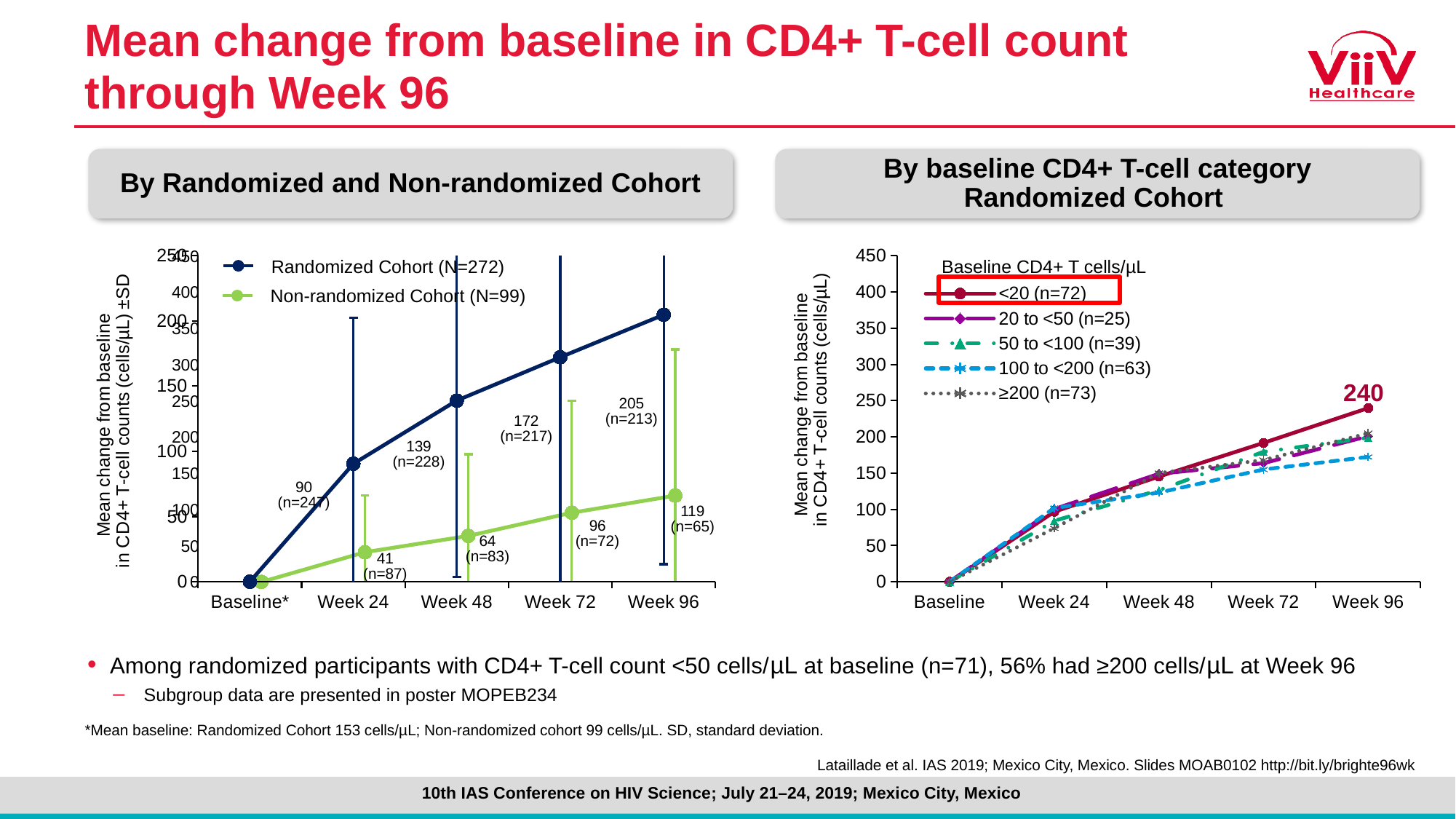
In the 'By baseline CD4+ T-cell category Randomized Cohort' chart, which baseline CD4+ category has the highest value at Week 96? <20 (n=72) In the 'By baseline CD4+ T-cell category Randomized Cohort' chart, how many series does the legend list? 5 In the 'By Randomized and Non-randomized Cohort' chart, which cohort has the larger mean change at Week 72? Randomized Cohort In the 'By baseline CD4+ T-cell category Randomized Cohort' chart, what is the value for the <20 (n=72) group at Week 96? 240 In the 'By Randomized and Non-randomized Cohort' chart, how many series does the legend list? 2 In the 'By Randomized and Non-randomized Cohort' chart, does the Non-randomized Cohort value rise or fall from Baseline to Week 96? rise What kind of chart is the 'By baseline CD4+ T-cell category Randomized Cohort' chart? line chart In the 'By Randomized and Non-randomized Cohort' chart, what is the n for the Randomized Cohort at Week 48? n=228 In the 'By Randomized and Non-randomized Cohort' chart, what is the mean change from baseline for the Randomized Cohort at Week 96? 205 In the 'By Randomized and Non-randomized Cohort' chart, what is the difference between the Randomized and Non-randomized Cohort values at Week 24? 49 In the 'By Randomized and Non-randomized Cohort' chart, what is the mean change from baseline for the Non-randomized Cohort at Week 48? 64 In the 'By Randomized and Non-randomized Cohort' chart, how many time points are shown on the x axis? 5